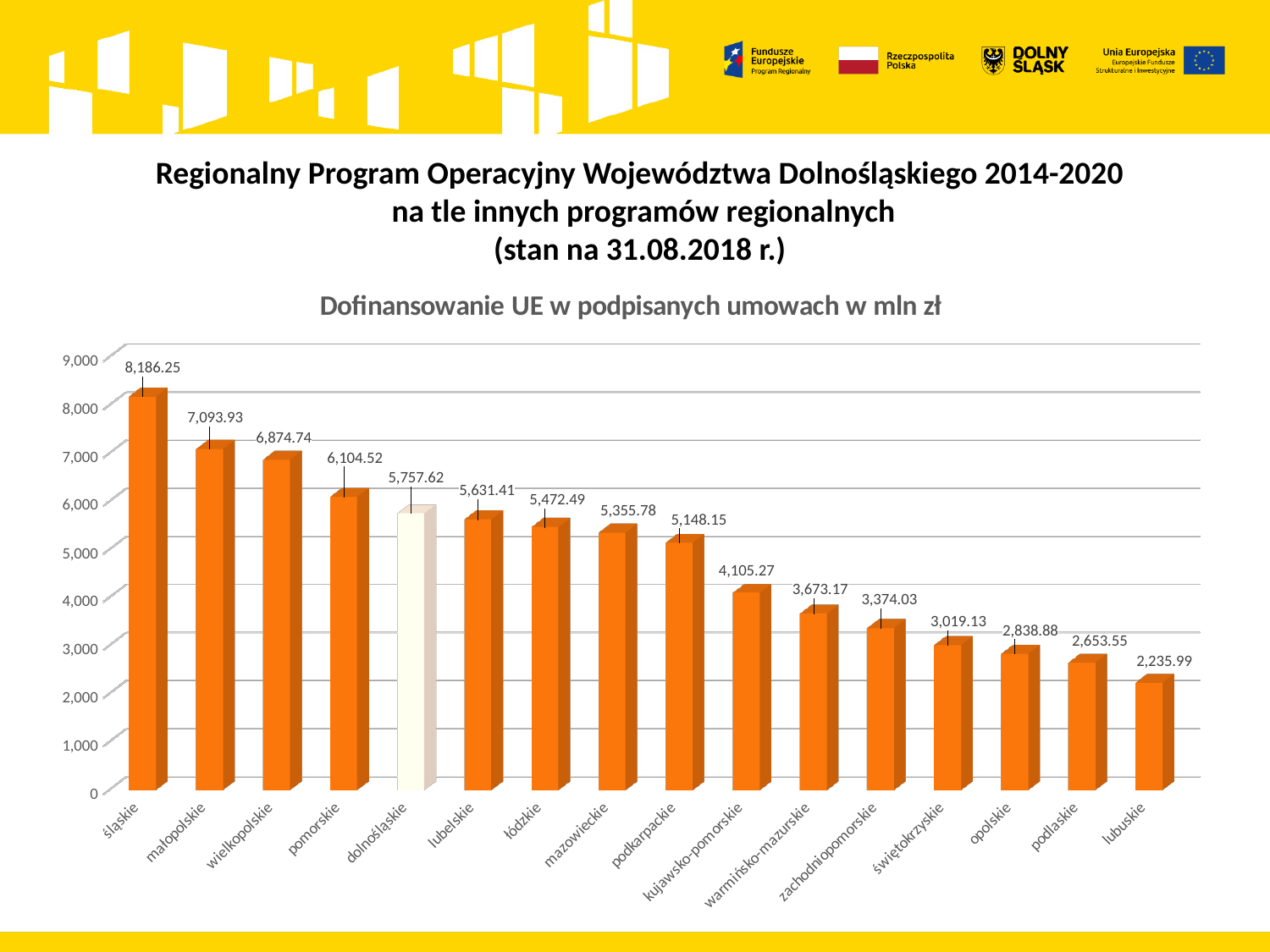
Which is larger, the value for pomorskie or the value for wielkopolskie? wielkopolskie Do the values rise or fall from left to right along the x axis? fall What kind of chart is this? bar chart What is the value for lubuskie? 2,235.99 What is the difference between the values for śląskie and małopolskie? 1,092.32 Which region has the lowest value? lubuskie Which region has the highest value? śląskie What is the difference between the values for dolnośląskie and lubelskie? 126.21 What is the value for dolnośląskie? 5,757.62 What is the title of the chart? Dofinansowanie UE w podpisanych umowach w mln zł How many regions are shown on the chart? 16 What is the value for mazowieckie? 5,355.78